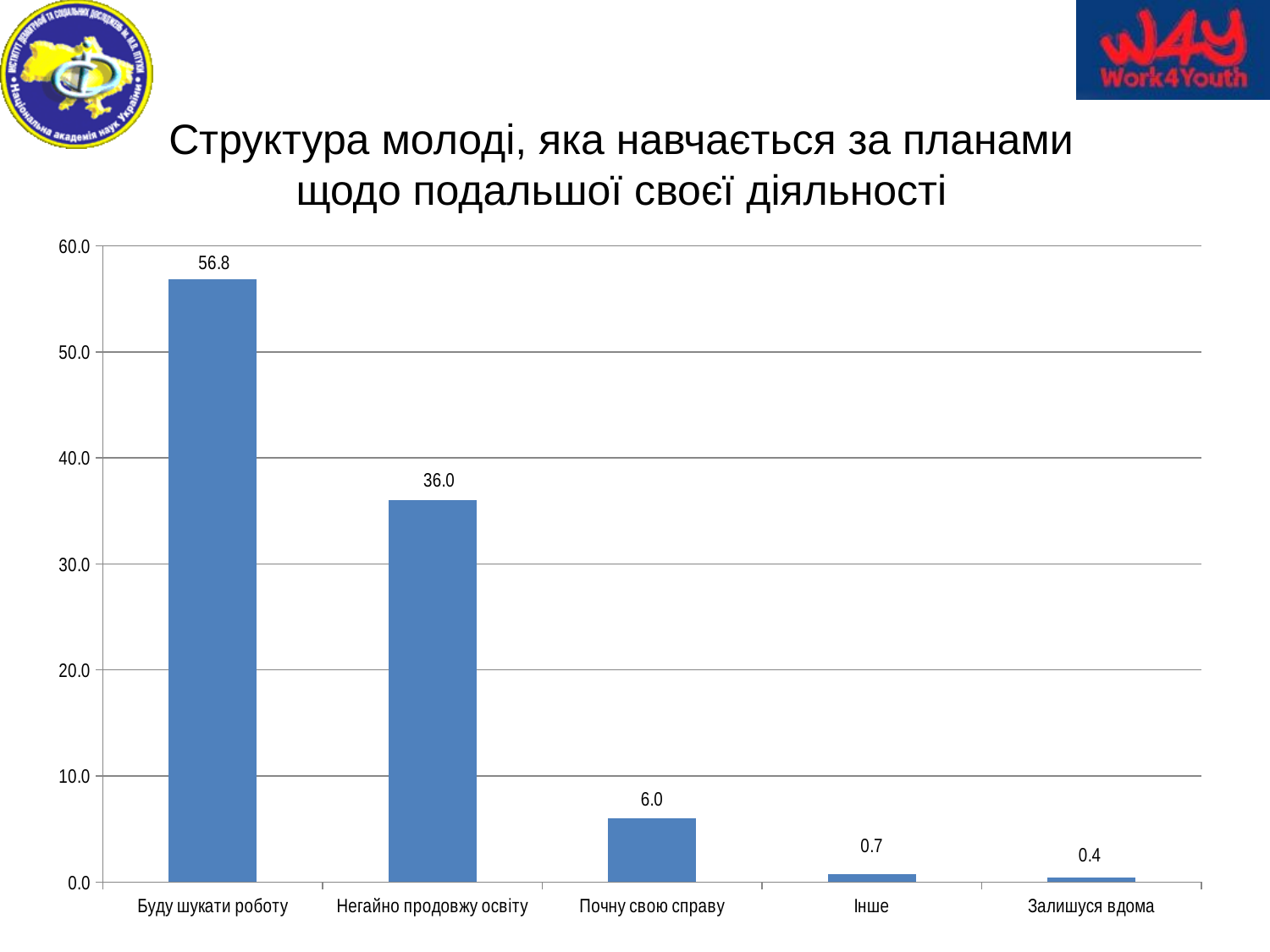
Which category has the highest value? Буду шукати роботу What is the value for "Буду шукати роботу"? 56.8 What is the value for "Залишуся вдома"? 0.4 What is the value for "Негайно продовжу освіту"? 36.0 What is the value for "Почну свою справу"? 6.0 Is the value for "Негайно продовжу освіту" greater or less than 40.0? less Which category has the lowest value? Залишуся вдома Do the values rise or fall from left to right along the x axis? fall How many categories are shown on the x axis? 5 What is the difference between the values for "Буду шукати роботу" and "Негайно продовжу освіту"? 20.8 Which is larger: the value for "Інше" or the value for "Залишуся вдома"? Інше What kind of chart is shown on the slide? bar chart